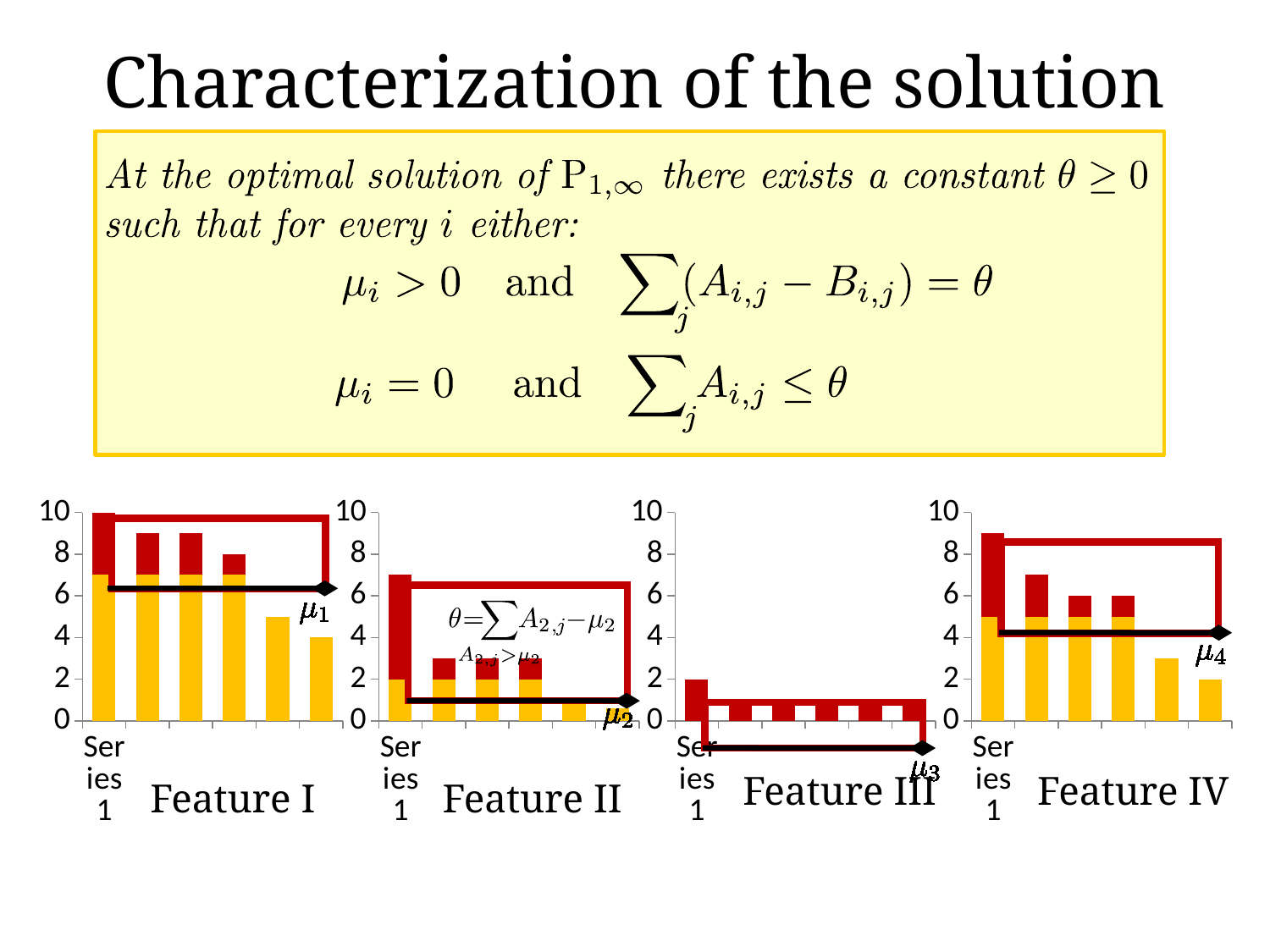
In the Feature IV chart, is the total height of the Series 1 bar greater or less than 8? greater In the Feature I chart, is the total height of the Series 1 bar greater or less than 8? greater In the Feature II chart, is the total height of the Series 1 bar greater or less than 6? greater In the Feature IV chart, is the first bar or the last bar taller? the first bar How many bars are plotted in the Feature II chart? 6 What is the highest value shown on the y axis of the Feature III chart? 10 In the Feature I chart, which bar is the tallest? Series 1 (the first bar) What kind of chart is the Feature I chart? bar chart In the Feature I chart, do the bar heights generally rise or fall from left to right? fall How many bar charts are shown on the slide? 4 What two colours are used for the stacked segments in the Feature II chart? yellow and red